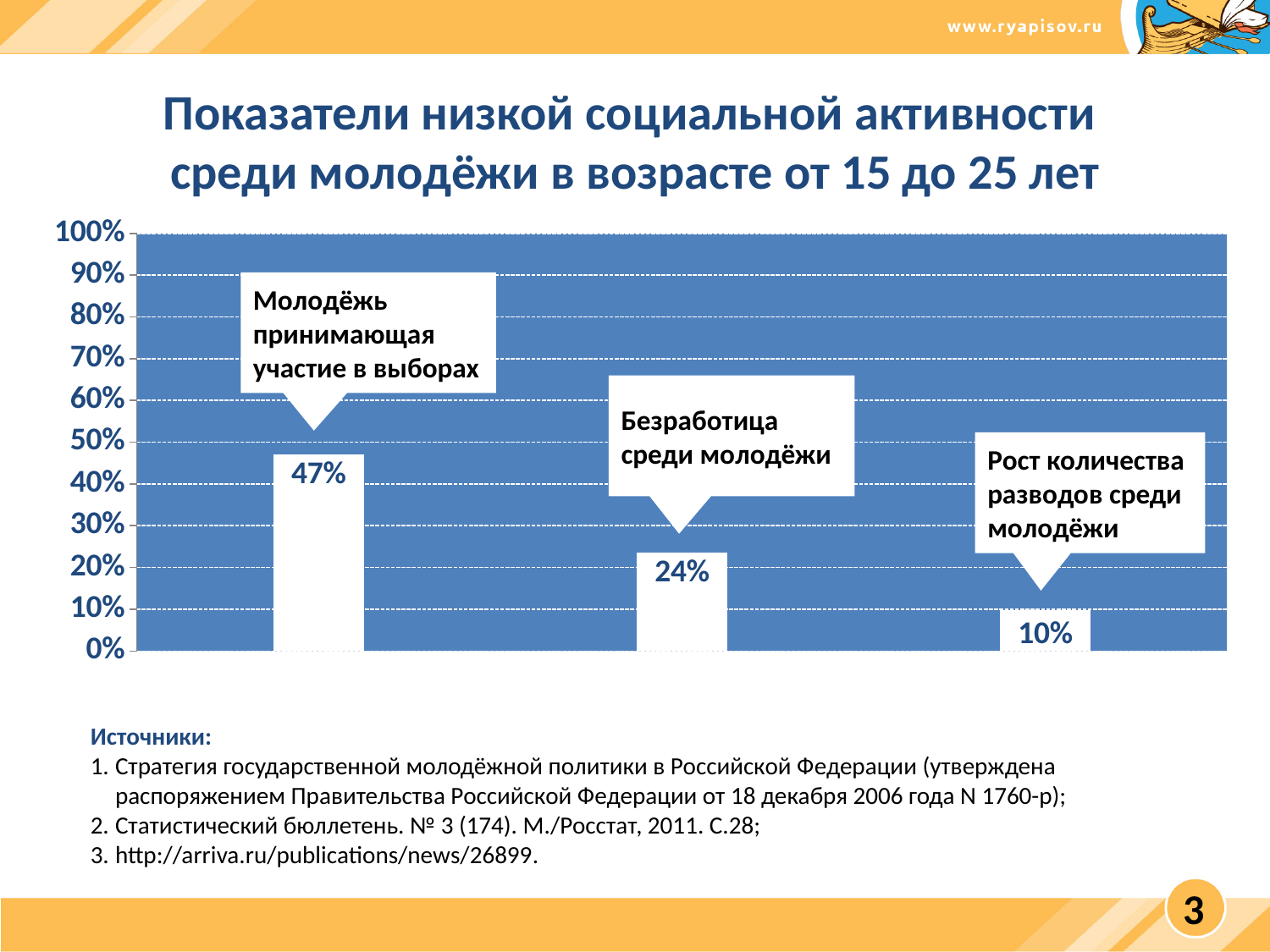
Is the value for "Молодёжь принимающая участие в выборах" greater or less than 50%? less What is the difference between the value for "Молодёжь принимающая участие в выборах" and the value for "Безработица среди молодёжи"? 23% Which category has the lowest value? Рост количества разводов среди молодёжи What kind of chart is shown on the slide? bar chart Do the values rise or fall from left to right across the chart? fall What is the value for "Молодёжь принимающая участие в выборах"? 47% What is the value for "Безработица среди молодёжи"? 24% Which category has the highest value? Молодёжь принимающая участие в выборах What is the difference between the value for "Безработица среди молодёжи" and the value for "Рост количества разводов среди молодёжи"? 14% How many bars are plotted on the chart? 3 What is the value for "Рост количества разводов среди молодёжи"? 10% Which is larger: the value for "Безработица среди молодёжи" or the value for "Рост количества разводов среди молодёжи"? Безработица среди молодёжи